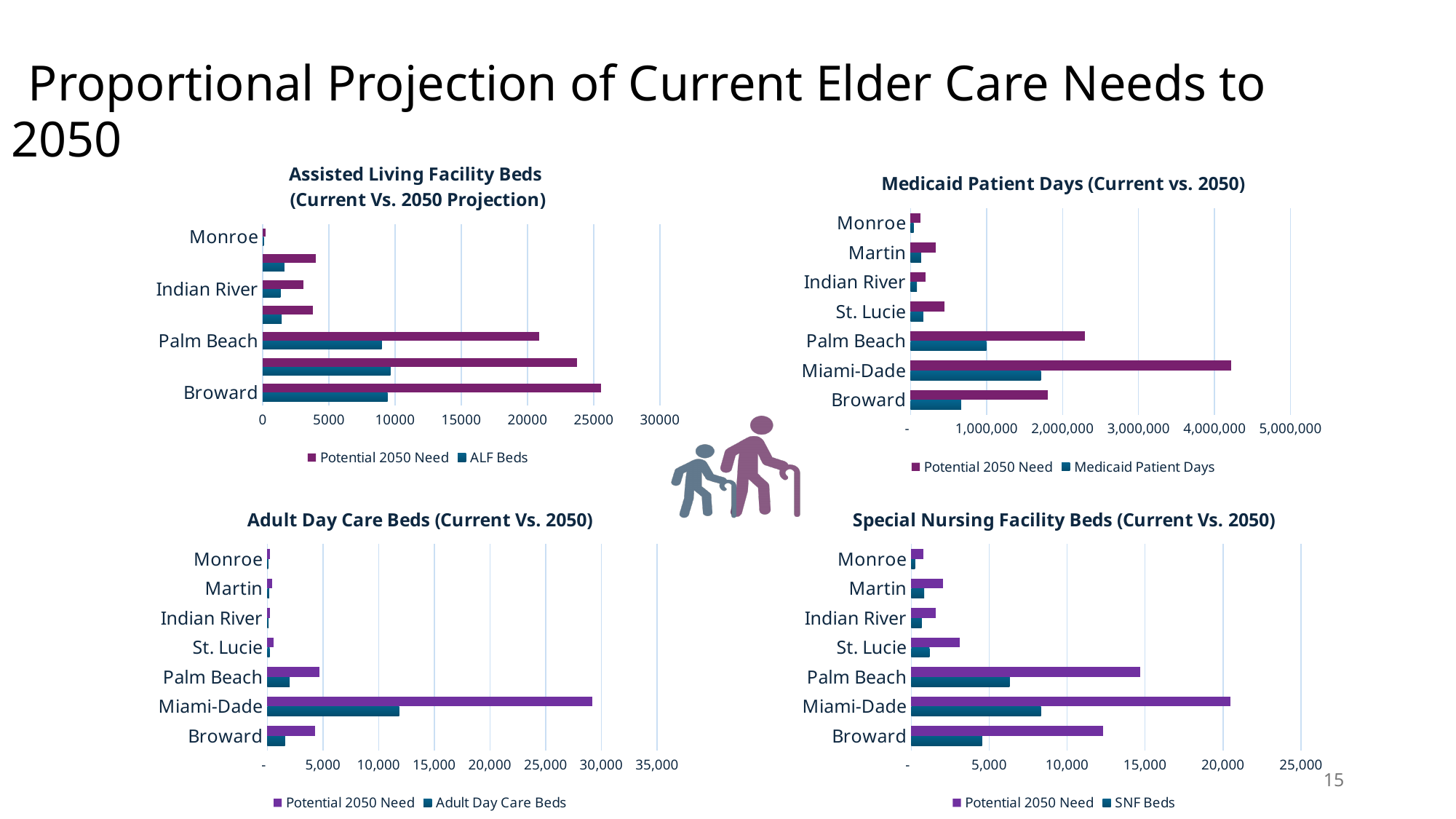
In the Medicaid Patient Days chart, is the Potential 2050 Need for Broward greater or less than 2,000,000? less In the Special Nursing Facility Beds chart, which is larger: the Potential 2050 Need for Palm Beach or for Broward? Palm Beach In the Medicaid Patient Days chart, which county has the lowest Potential 2050 Need? Monroe What kind of chart is the Adult Day Care Beds chart? Bar chart In the Adult Day Care Beds chart, is the Adult Day Care Beds value for Miami-Dade greater or less than 10,000? greater In the Special Nursing Facility Beds chart, is the SNF Beds value for Miami-Dade greater or less than 10,000? less In the Medicaid Patient Days chart, which county has the highest Potential 2050 Need? Miami-Dade How many series does the legend of the Assisted Living Facility Beds chart list? 2 How many counties are shown in the Medicaid Patient Days chart? 7